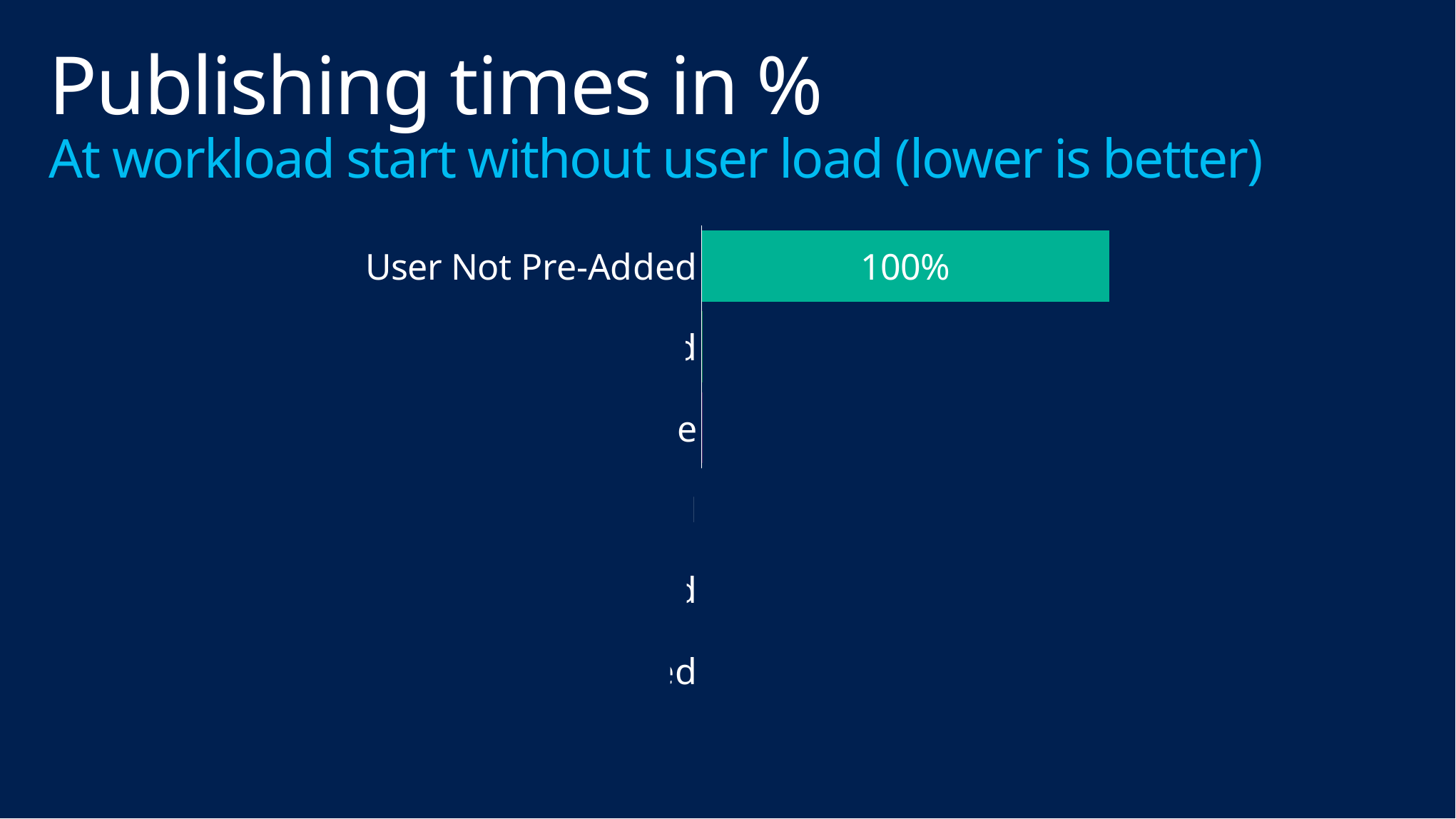
What kind of chart is shown on the slide? bar chart What is the value shown for User Not Pre-Added? 100% Is the value for User Not Pre-Added greater or less than 50%? greater Which category has a bar labelled 100%? User Not Pre-Added What is the title of the chart on the slide? Publishing times in %